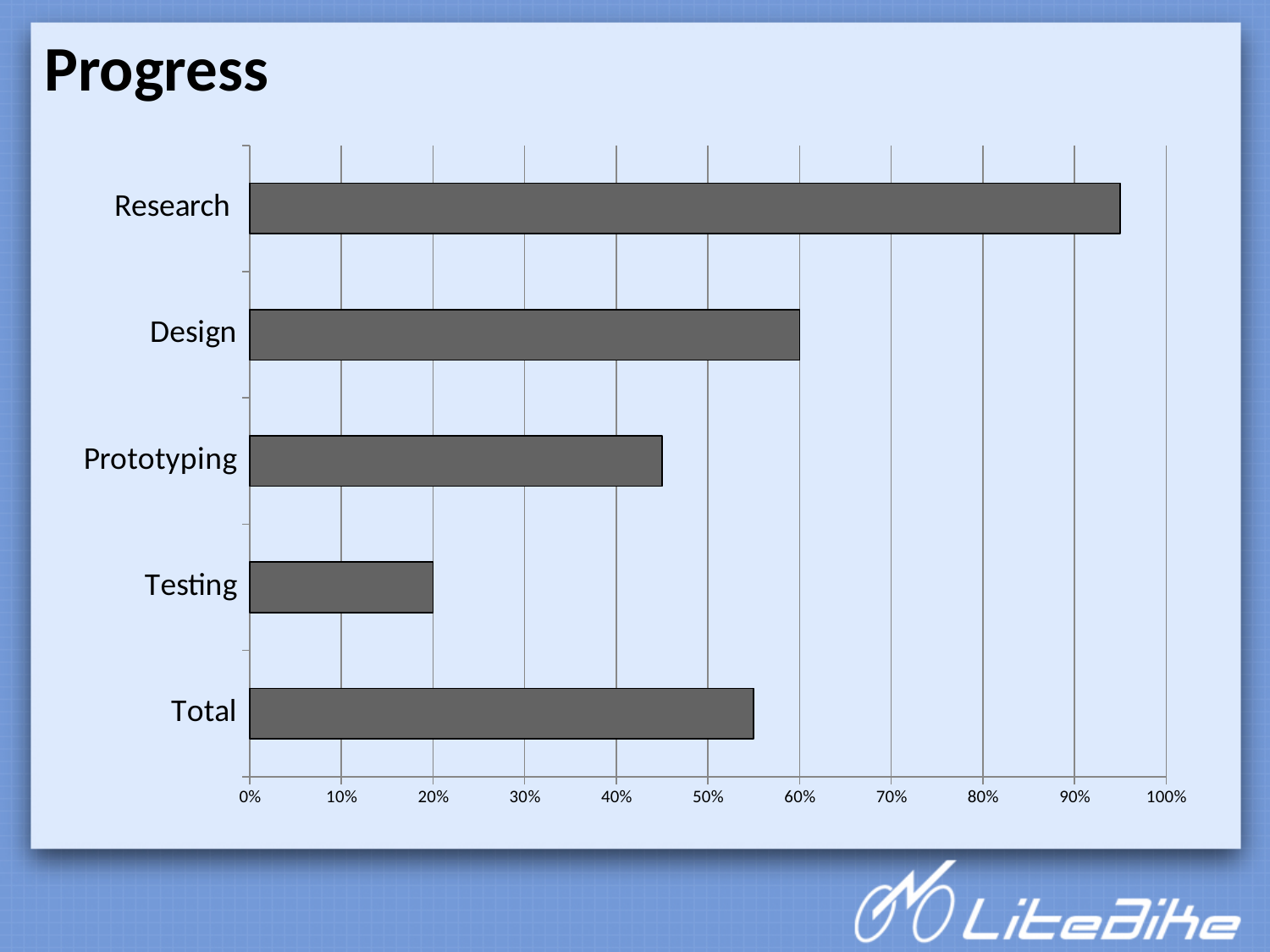
Which category has the lowest value? Testing Which is larger, the value for Prototyping or the value for Total? Total Is the value for Prototyping greater or less than 50%? less What is the difference between the values for Design and Testing? 40% Is the value for Research greater or less than 90%? greater What is the value for Design? 60% What kind of chart is shown on the slide? bar chart How many categories are plotted in the chart? 5 Which category has the highest value? Research What is the value for Testing? 20% What is the title of the slide containing the chart? Progress Which is larger, the value for Research or the value for Design? Research